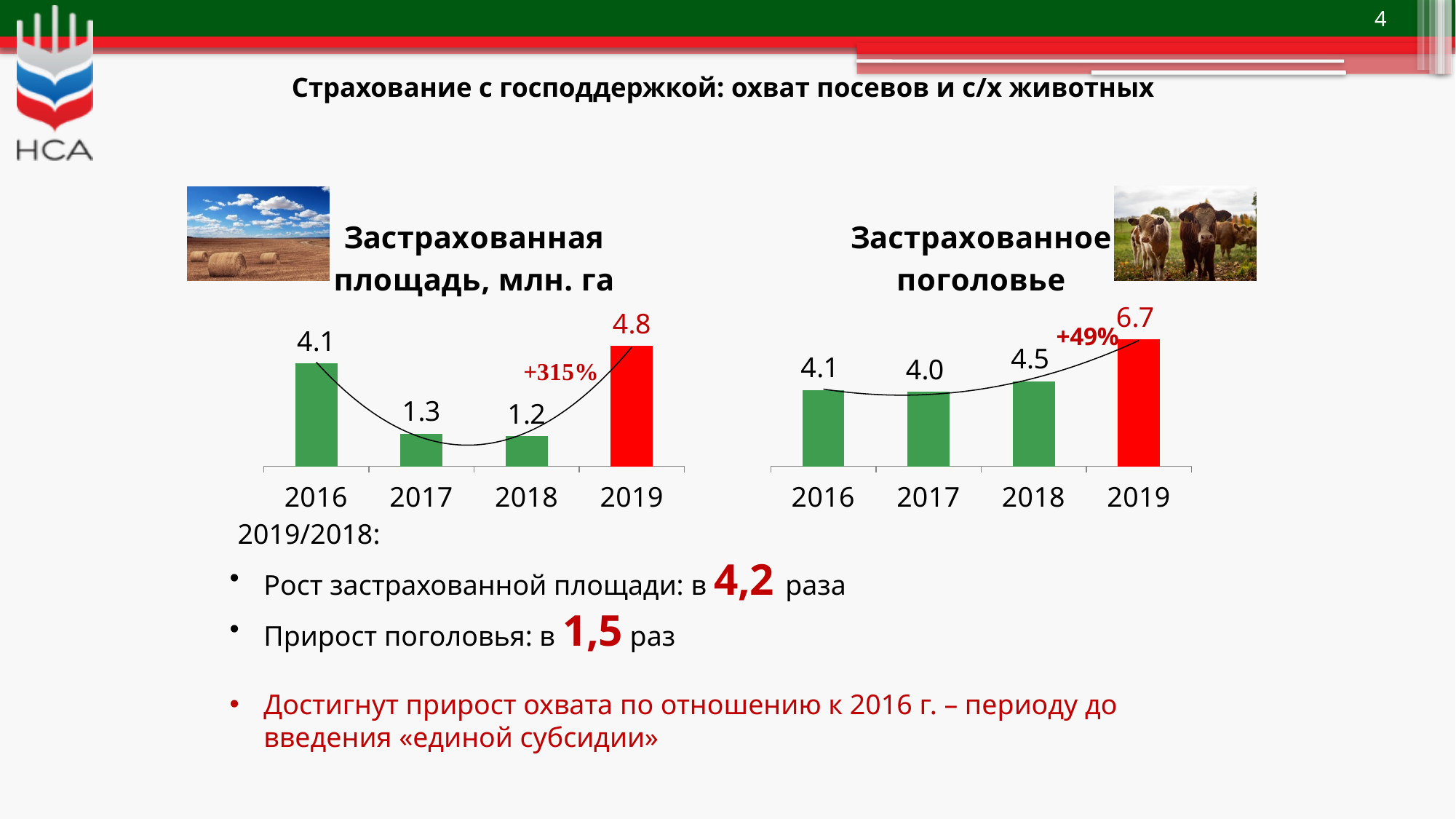
In the chart titled "Застрахованное поголовье", which is larger, the value for 2016 or the value for 2017? 2016 In the chart titled "Застрахованная площадь, млн. га", what percentage change is annotated between 2018 and 2019? +315% In the chart titled "Застрахованная площадь, млн. га", what is the difference between the 2019 and 2018 values? 3.6 How many years are shown on the x axis of the chart titled "Застрахованное поголовье"? 4 In the chart titled "Застрахованная площадь, млн. га", which is larger, the value for 2017 or the value for 2018? 2017 In the chart titled "Застрахованное поголовье", what is the value for 2018? 4.5 In the chart titled "Застрахованное поголовье", which year has the highest value? 2019 In the chart titled "Застрахованная площадь, млн. га", which year has the lowest value? 2018 What kind of chart is the chart titled "Застрахованная площадь, млн. га"? bar chart In the chart titled "Застрахованная площадь, млн. га", what is the value for 2019? 4.8 In the chart titled "Застрахованное поголовье", what is the difference between the 2019 and 2018 values? 2.2 In the chart titled "Застрахованное поголовье", do the values rise or fall from 2017 to 2019? rise